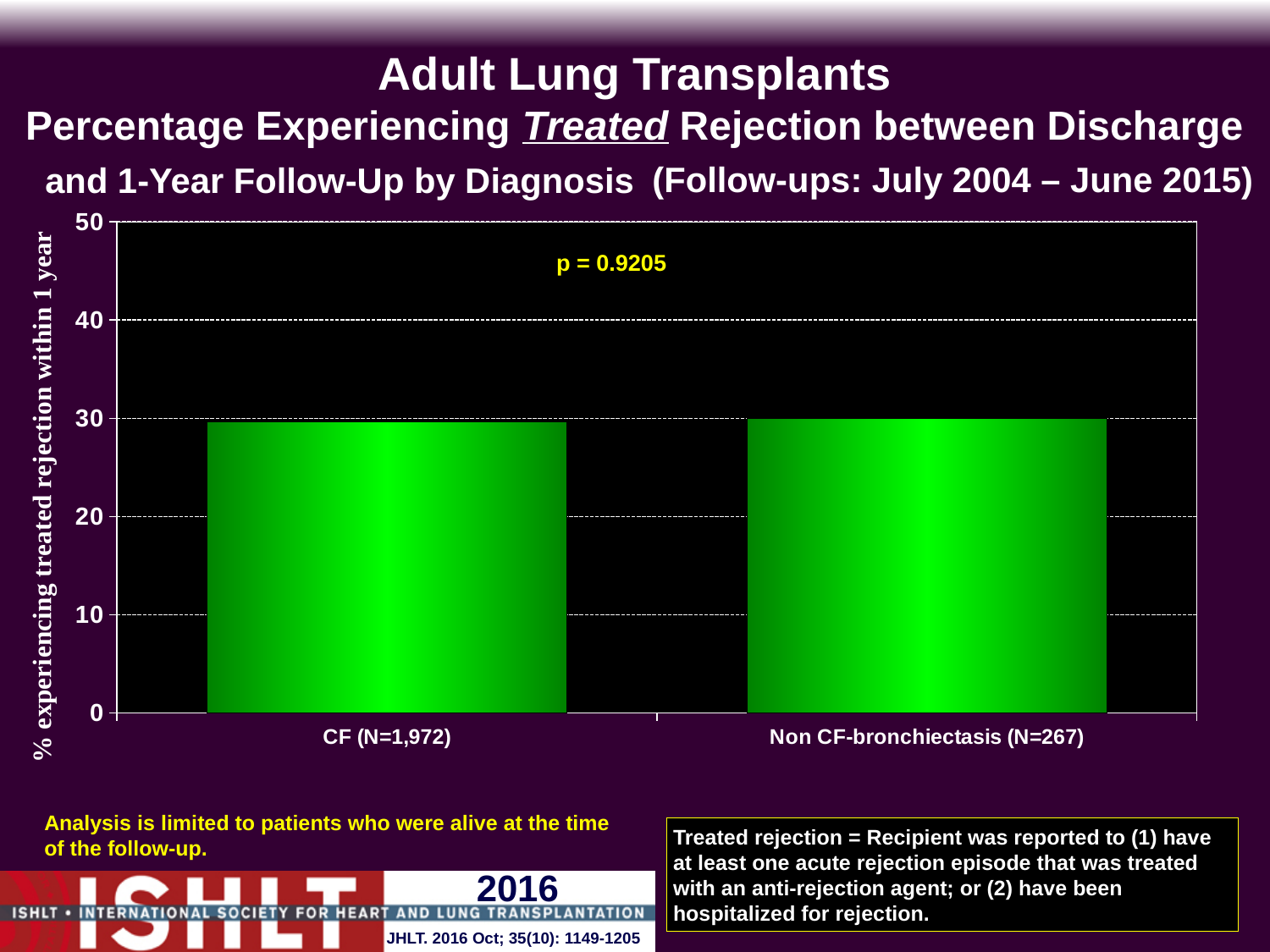
Is the value for Non CF-bronchiectasis (N=267) greater or less than 40? less What is the sample size (N) shown for the Non CF-bronchiectasis category? 267 Is the value for Non CF-bronchiectasis (N=267) greater or less than 20? greater What is the maximum value shown on the y-axis of the chart? 50 How many diagnosis categories are plotted in the chart? 2 What p-value is printed on the chart? p = 0.9205 Is the value for CF (N=1,972) greater or less than 20? greater What is the sample size (N) shown for the CF category? 1,972 What kind of chart is shown on the slide? bar chart